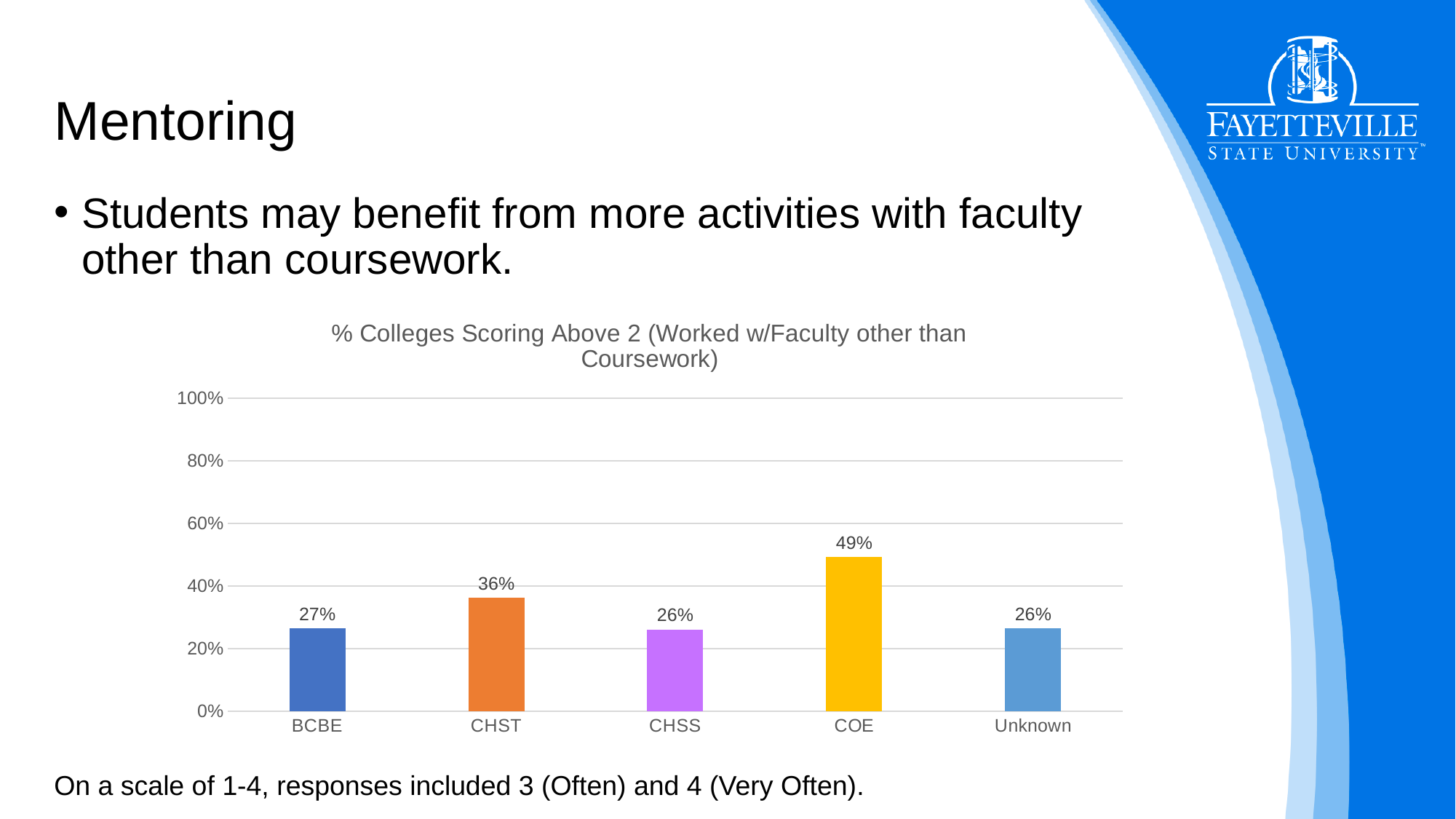
What is the value for BCBE? 27% How many categories are shown on the x axis? 5 What is the difference between the values for COE and CHST? 13% What kind of chart is shown on the slide? bar chart What is the difference between the values for BCBE and CHSS? 1% Which is larger, the value for CHST or the value for BCBE? CHST What is the value for Unknown? 26% Is the value for COE greater or less than 40%? greater Which category has the highest value? COE What is the value for COE? 49% What is the title of the chart? % Colleges Scoring Above 2 (Worked w/Faculty other than Coursework) What is the value for CHST? 36%